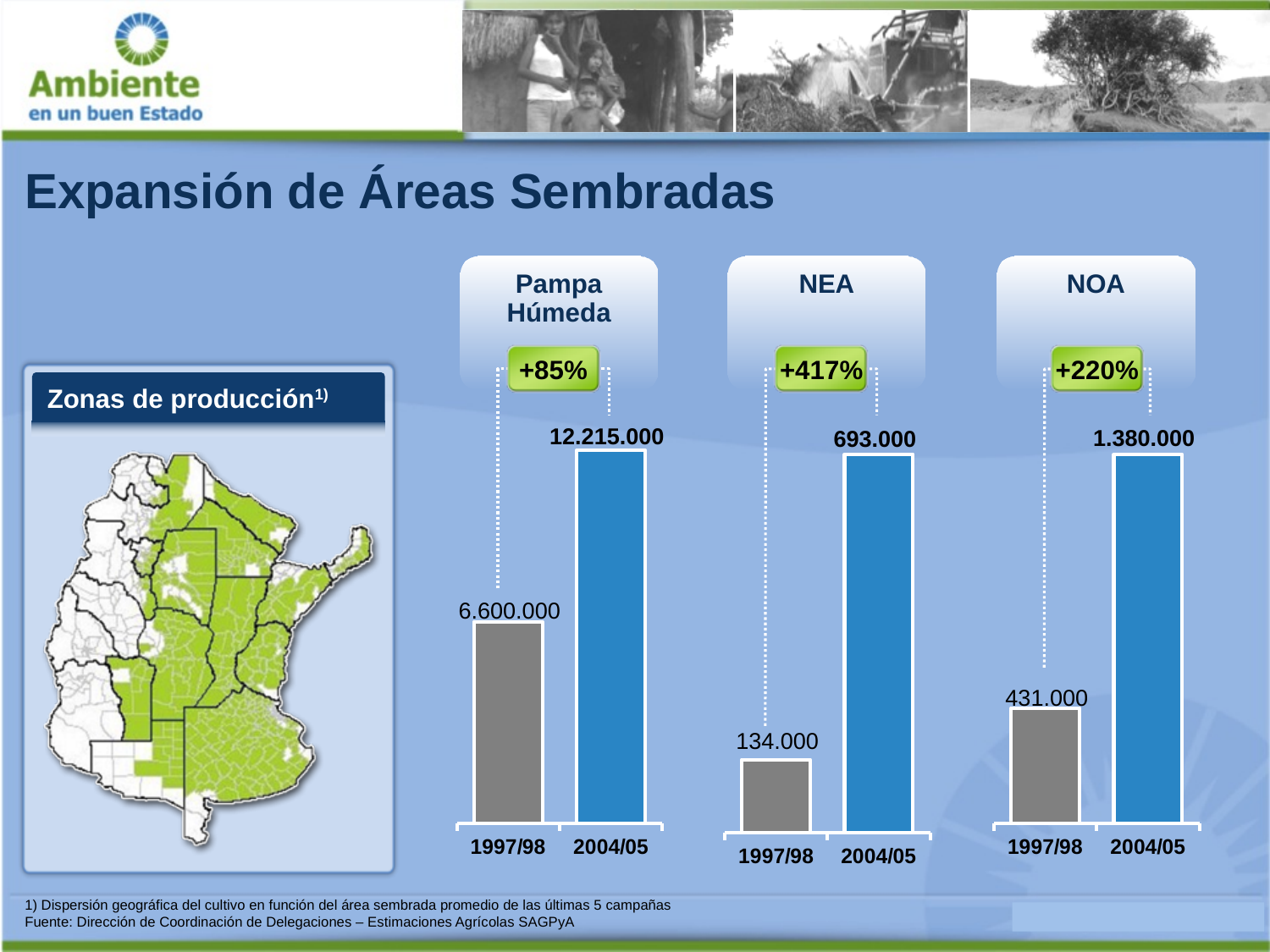
In the NOA chart, what is the value for 2004/05? 1.380.000 In the NOA chart, what is the value for 1997/98? 431.000 What percentage increase is shown above the NEA chart? +417% In the Pampa Húmeda chart, which period has the higher value, 1997/98 or 2004/05? 2004/05 In the NEA chart, what is the difference between the 2004/05 and 1997/98 values? 559.000 In the NEA chart, what is the value for 1997/98? 134.000 In the Pampa Húmeda chart, what is the value for 2004/05? 12.215.000 What kind of chart is used for the NEA data? Bar chart In the NEA chart, what is the value for 2004/05? 693.000 In the NOA chart, what is the difference between the 2004/05 and 1997/98 values? 949.000 How many bars are shown in the NOA chart? 2 In the Pampa Húmeda chart, what is the value for 1997/98? 6.600.000